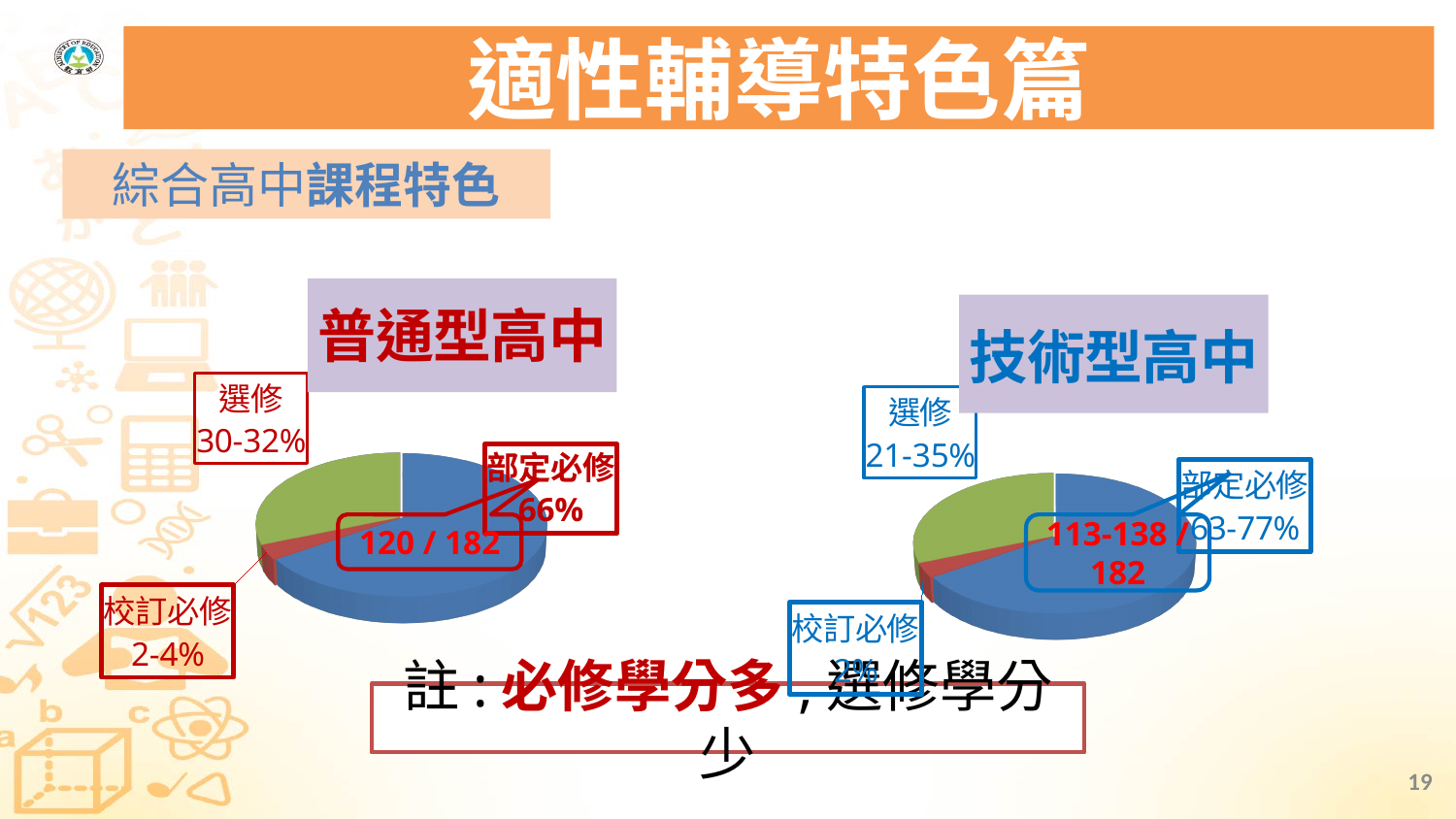
In the 技術型高中 chart, which is larger, 部定必修 or 選修? 部定必修 In the 普通型高中 chart, what is the value for 校訂必修? 2-4% In the 普通型高中 chart, which category has the largest slice? 部定必修 In the 技術型高中 chart, what is the value for 選修? 21-35% In the 技術型高中 chart, which category has the largest slice? 部定必修 What fraction label is shown on the 普通型高中 chart? 120 / 182 How many slices does the 普通型高中 pie chart have? 3 In the 普通型高中 chart, what is the value for 選修? 30-32% What kind of chart is used for 普通型高中 on the left? pie chart In the 普通型高中 chart, what is the value for 部定必修? 66% In the 普通型高中 chart, which category has the smallest slice? 校訂必修 In the 技術型高中 chart, what is the value for 部定必修? 63-77%